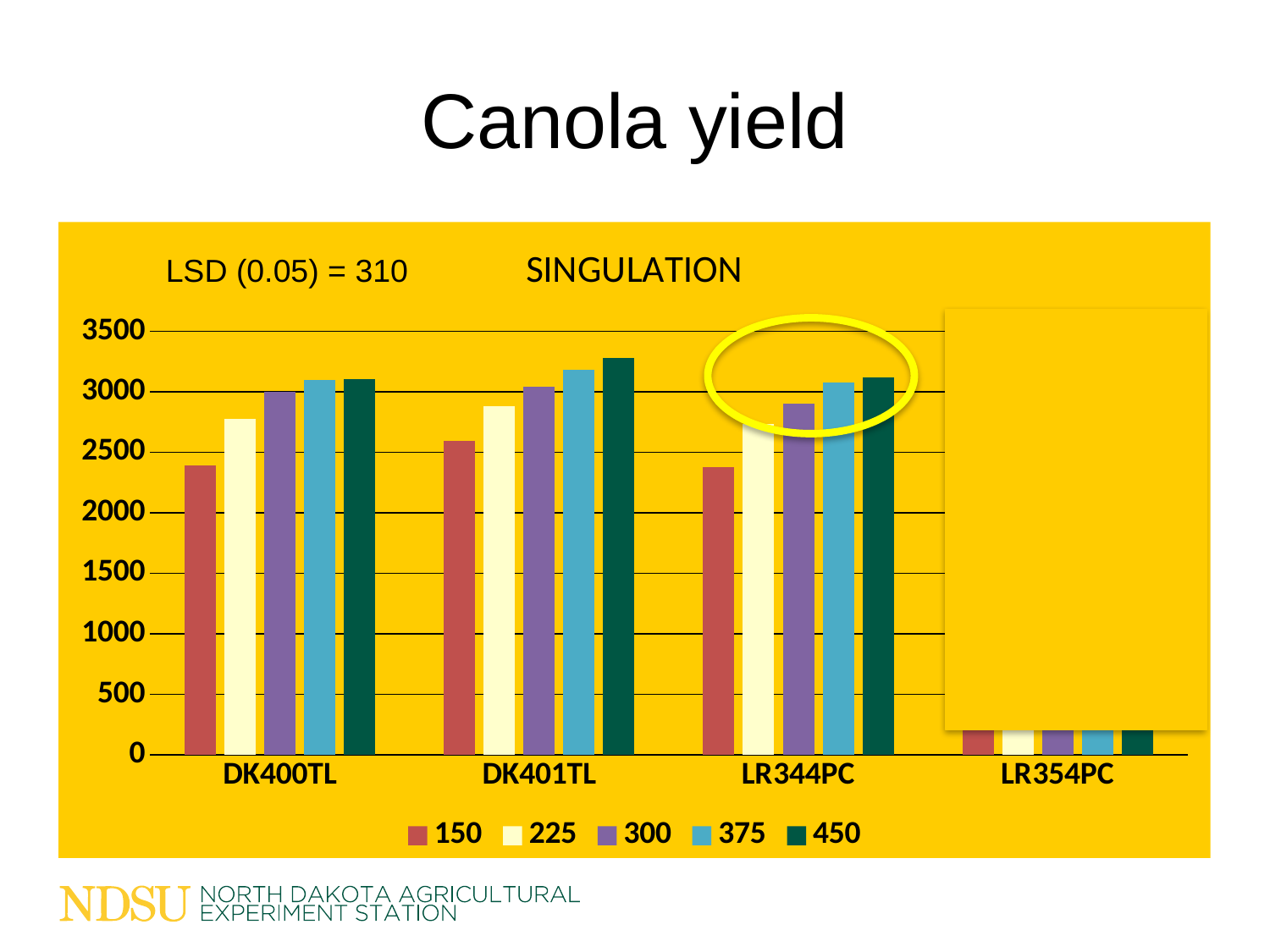
What kind of chart is shown on the slide? bar chart Which is larger: the 150 series value for DK401TL or the 150 series value for DK400TL? DK401TL How many canola varieties (categories) are shown on the x axis? 4 Is the value for the 150 series at LR344PC greater or less than 2500? less How many series does the legend list? 5 Is the value for the 450 series at DK401TL greater or less than 3000? greater Which is larger: the 450 series value for DK401TL or the 450 series value for DK400TL? DK401TL Within DK401TL, which series has the tallest bar? 450 Is the value for the 225 series at DK400TL greater or less than 2500? greater What LSD (0.05) value is printed on the chart? 310 Within DK400TL, which series has the shortest bar? 150